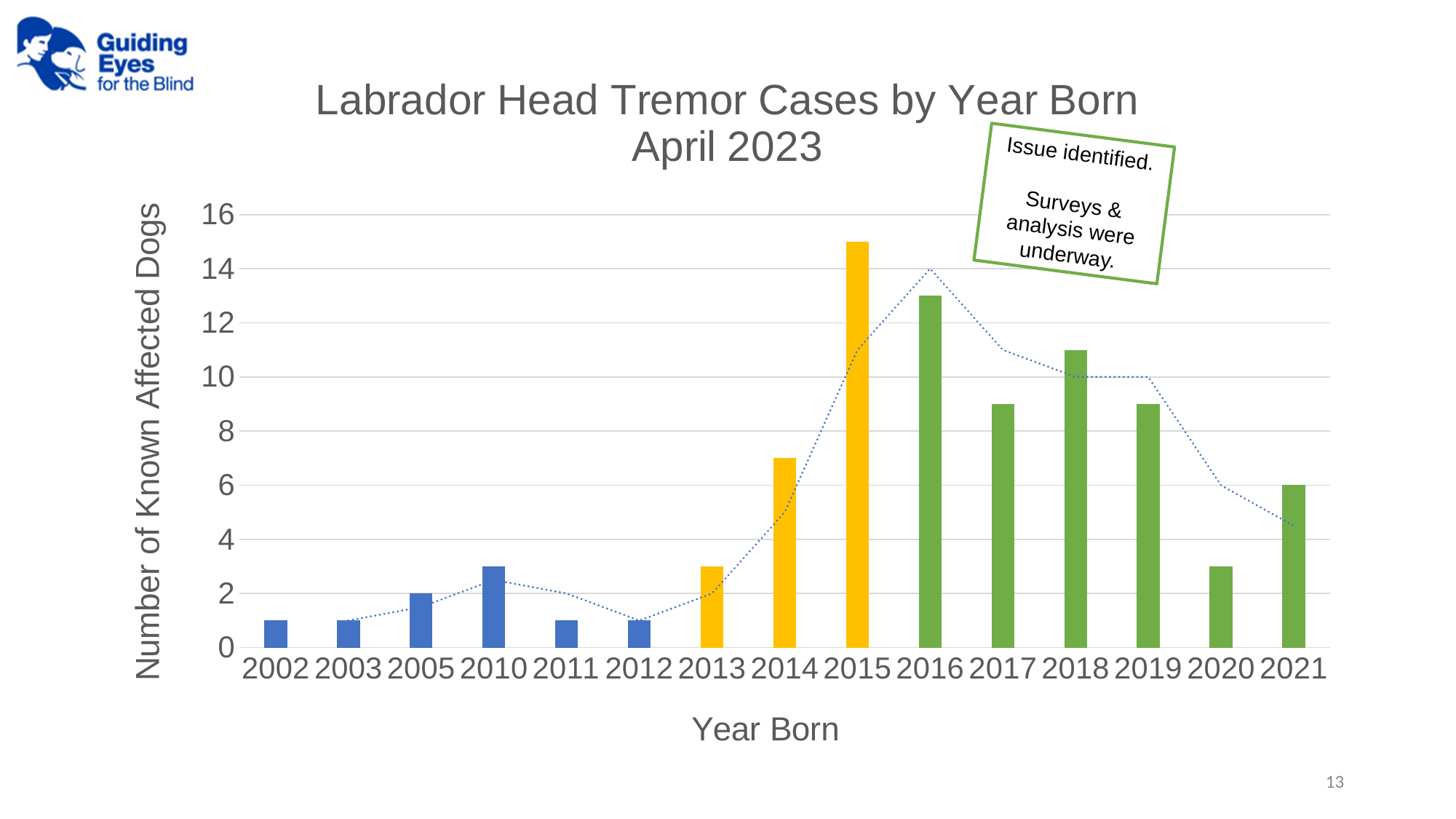
Is the value for 2020 greater or less than 4? less Do the values rise or fall from 2012 to 2015? rise How many year-born categories are shown on the x axis? 15 How many known affected dogs were born in 2005? 2 Is the value for 2015 greater or less than 14? greater How many known affected dogs were born in 2021? 6 Is the value for 2018 greater or less than 10? greater Which year born has the highest number of known affected dogs? 2015 What type of chart is shown on the slide? bar chart What is the title of the chart? Labrador Head Tremor Cases by Year Born April 2023 Which has more known affected dogs, 2015 or 2016? 2015